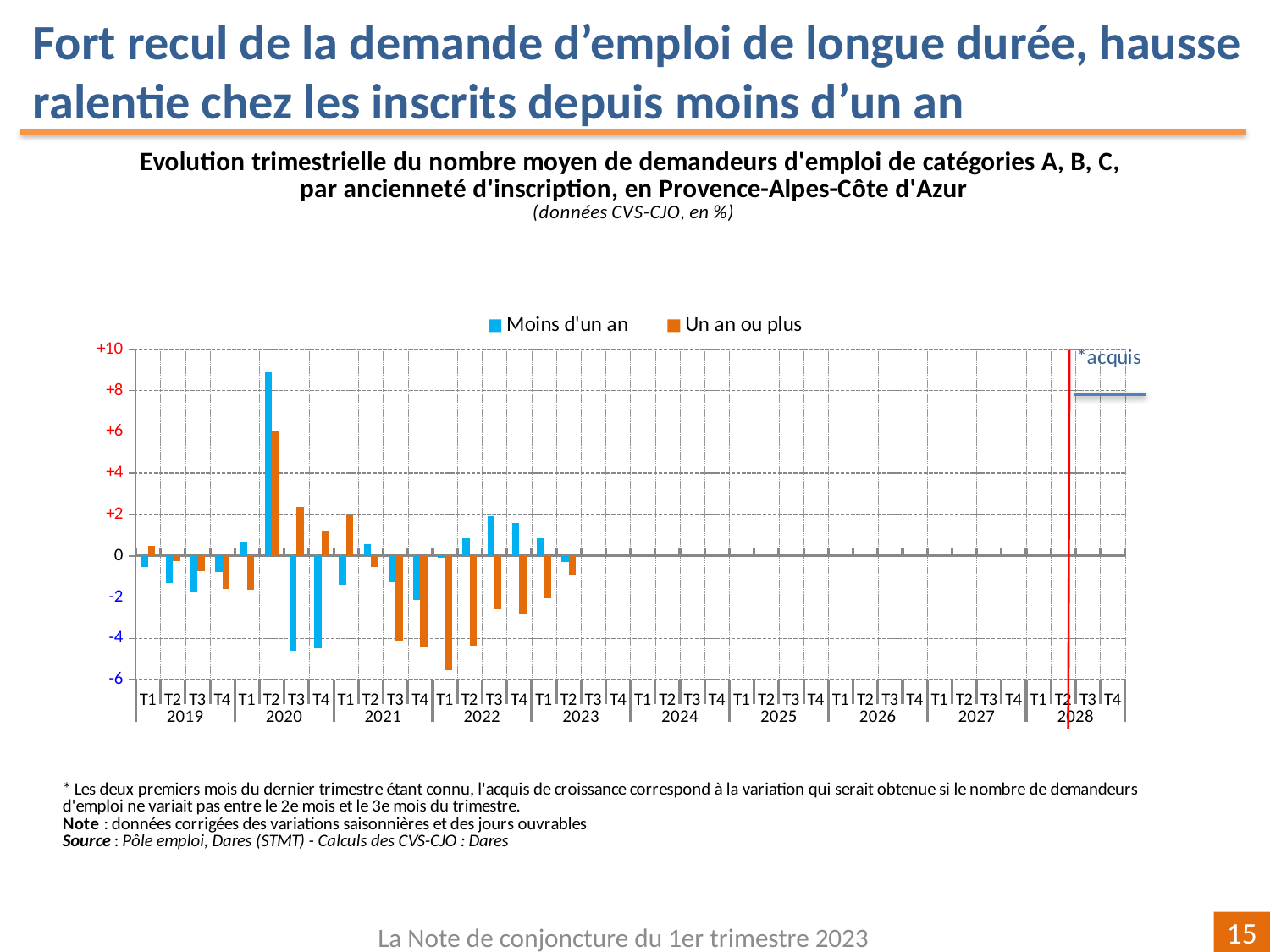
What kind of chart is shown on the slide? bar chart Is the value for 'Un an ou plus' in T2 2020 greater or less than +4? greater Is the value for 'Moins d'un an' in T3 2020 greater or less than -4? less In which quarter does the 'Moins d'un an' series reach its highest value? T2 2020 What are the two series named in the legend? Moins d'un an; Un an ou plus In T3 2021, which series has the larger value, 'Moins d'un an' or 'Un an ou plus'? Moins d'un an In T2 2020, which series has the larger value, 'Moins d'un an' or 'Un an ou plus'? Moins d'un an How many series does the legend list? 2 In which quarter does the 'Un an ou plus' series reach its lowest value? T1 2022 Is the value for 'Un an ou plus' in T1 2022 greater or less than -4? less Which series is shown in orange? Un an ou plus